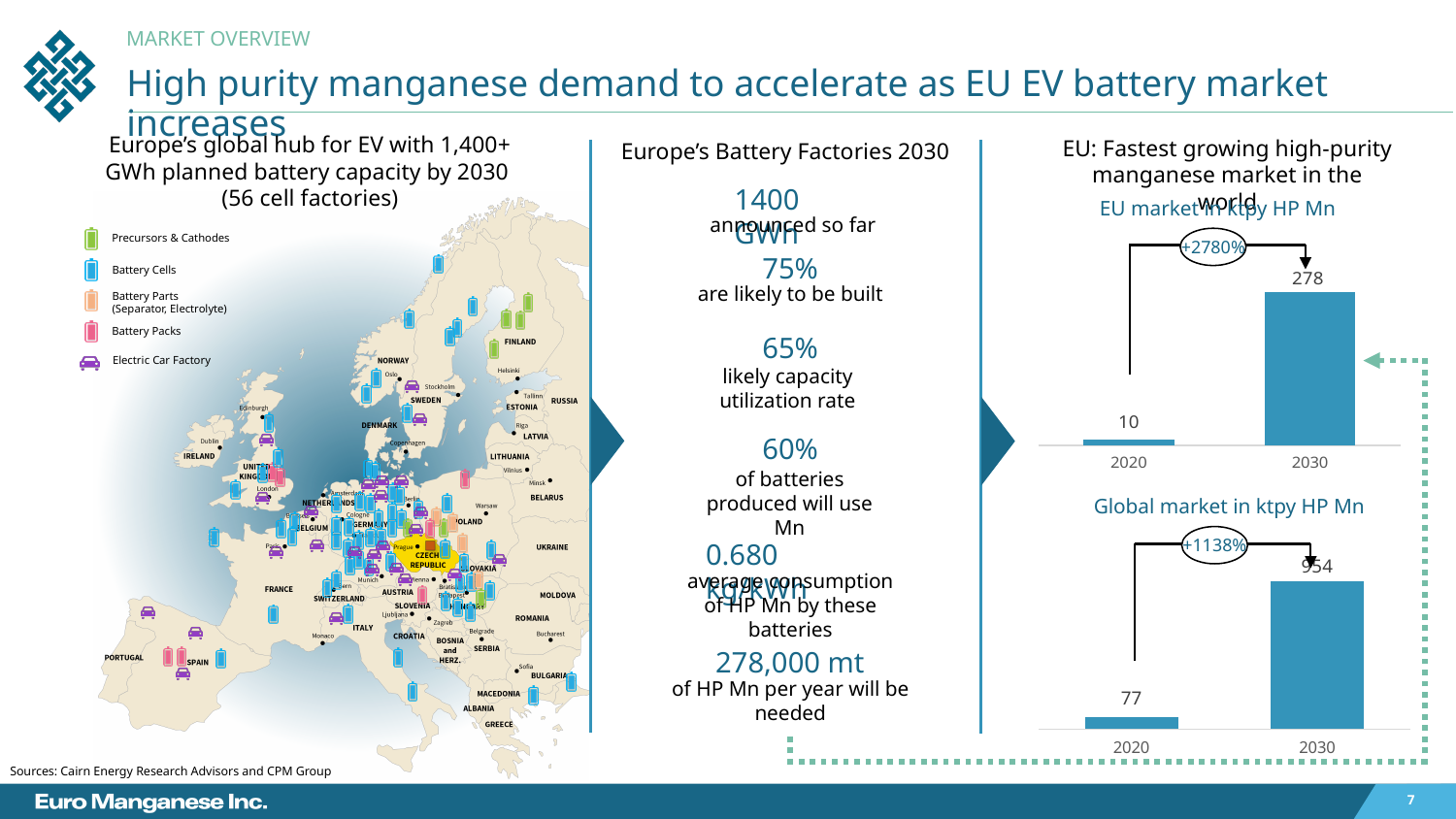
In the 'EU market in ktpy HP Mn' chart, what is the value for 2020? 10 What percentage growth is annotated on the 'EU market in ktpy HP Mn' chart? +2780% What type of chart is the 'EU market in ktpy HP Mn' chart? Bar chart In the 'Global market in ktpy HP Mn' chart, what is the value for 2020? 77 In the 'EU market in ktpy HP Mn' chart, which year has the lower value? 2020 In the 'EU market in ktpy HP Mn' chart, what is the difference between the 2030 and 2020 values? 268 In the 'Global market in ktpy HP Mn' chart, what is the difference between the 2030 and 2020 values? 877 In the 'Global market in ktpy HP Mn' chart, which year has the higher value? 2030 In the 'EU market in ktpy HP Mn' chart, what is the value for 2030? 278 How many categories (years) are shown in the 'Global market in ktpy HP Mn' chart? 2 In the 'Global market in ktpy HP Mn' chart, what is the value for 2030? 954 What percentage growth is annotated on the 'Global market in ktpy HP Mn' chart? +1138%